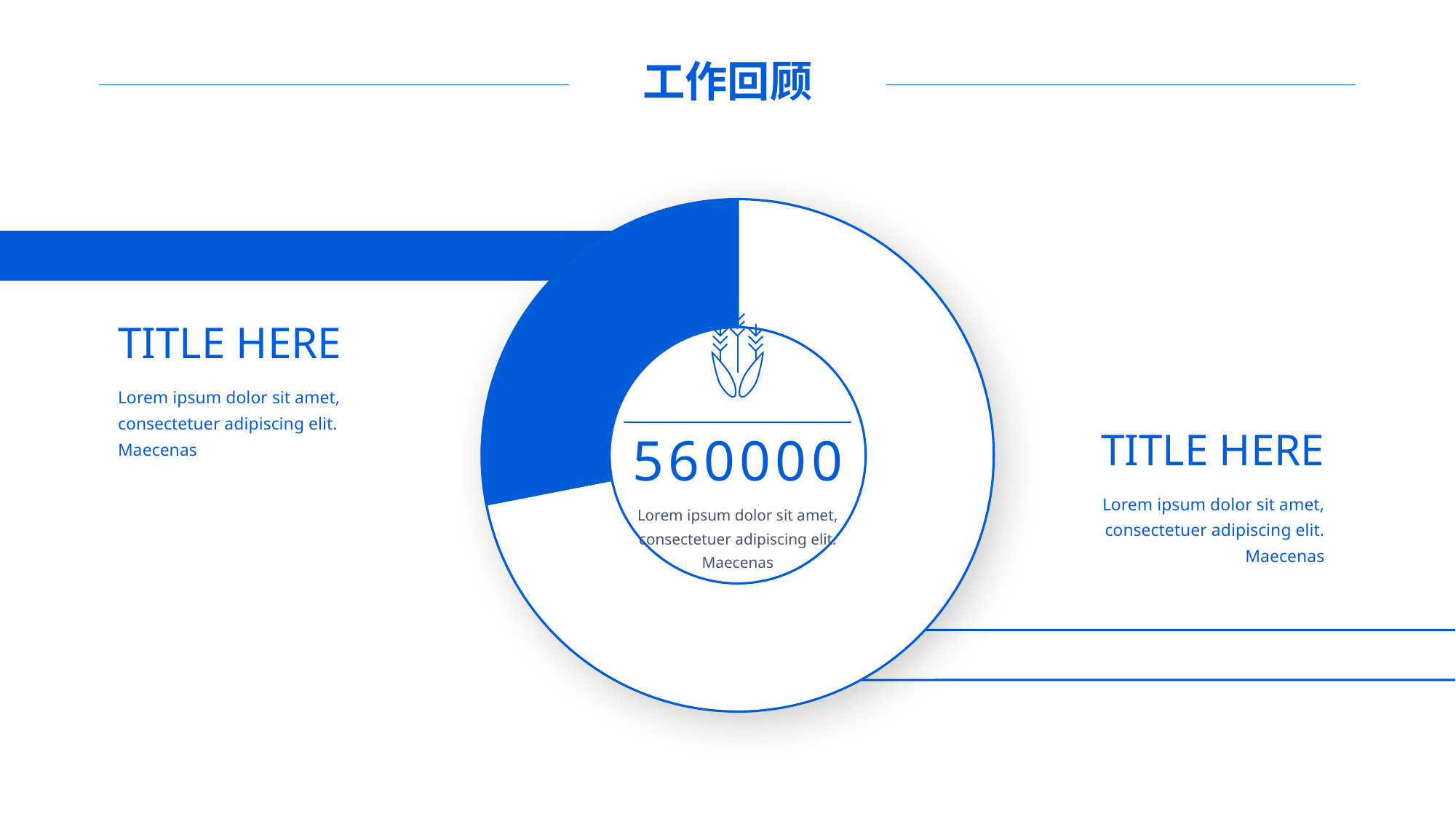
Which slice of the donut chart is larger, the blue filled slice or the white slice? The white slice What kind of chart is shown on the slide? Pie chart (donut) What is the title of the slide containing the donut chart? 工作回顾 What number is printed in the centre of the donut chart? 560000 How many slices does the donut chart have? 2 Which slice of the donut chart is the smallest? The blue filled slice Does the blue slice cover more or less than half of the donut chart? Less